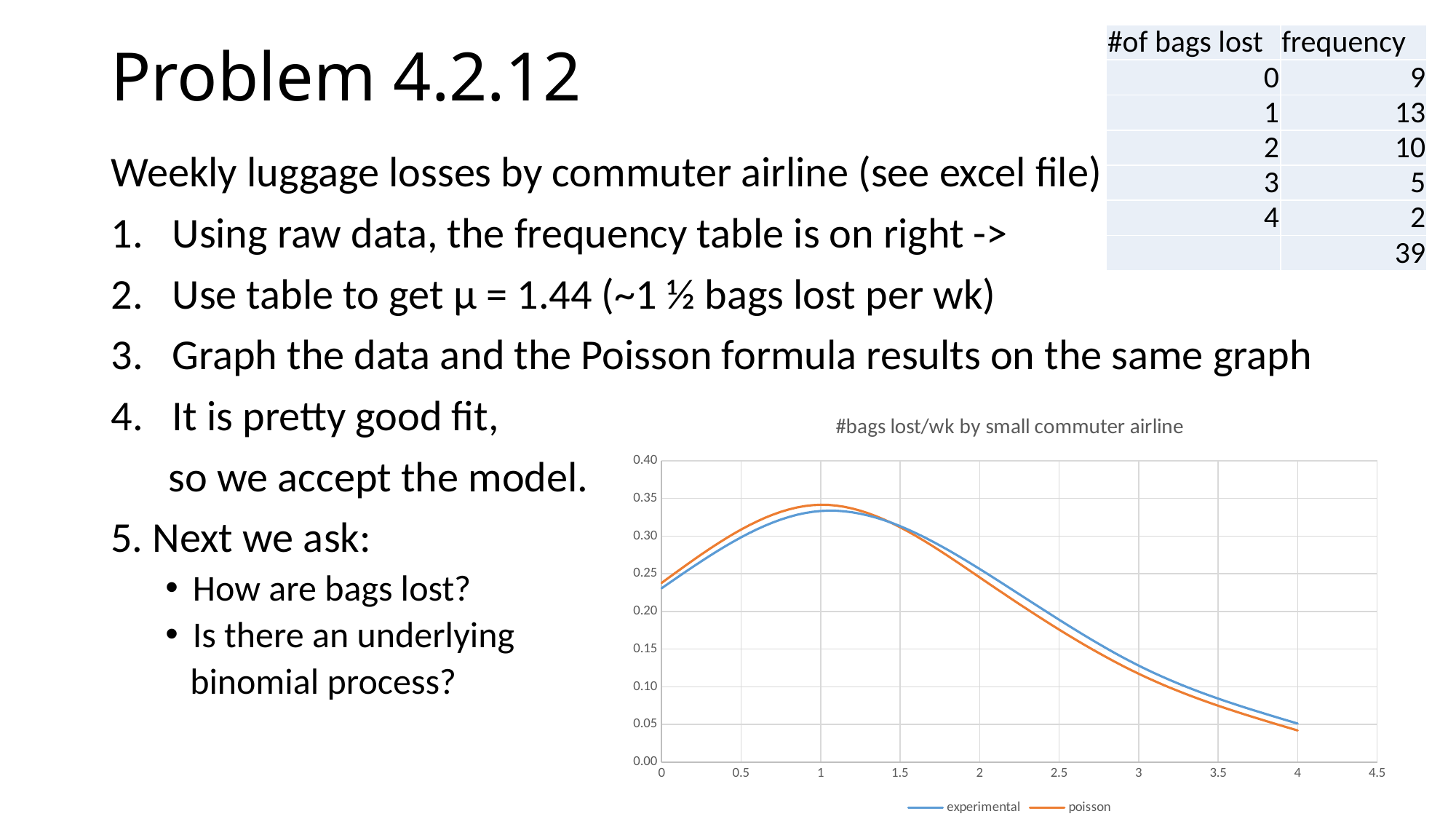
Do the values of both series rise or fall between x = 1 and x = 4? fall At which x value does the experimental series reach its highest point? 1 At x = 0, which series has the higher value, experimental or poisson? poisson Is the poisson value at x = 4 greater or less than 0.05? less How many series does the chart legend list? 2 Is the experimental value at x = 1 greater or less than 0.30? greater What kind of chart is shown on the slide? line chart What is the title of the chart? #bags lost/wk by small commuter airline At x = 3, which series has the higher value, experimental or poisson? experimental Is the experimental value at x = 3 greater or less than 0.10? greater Which series is drawn in orange? poisson